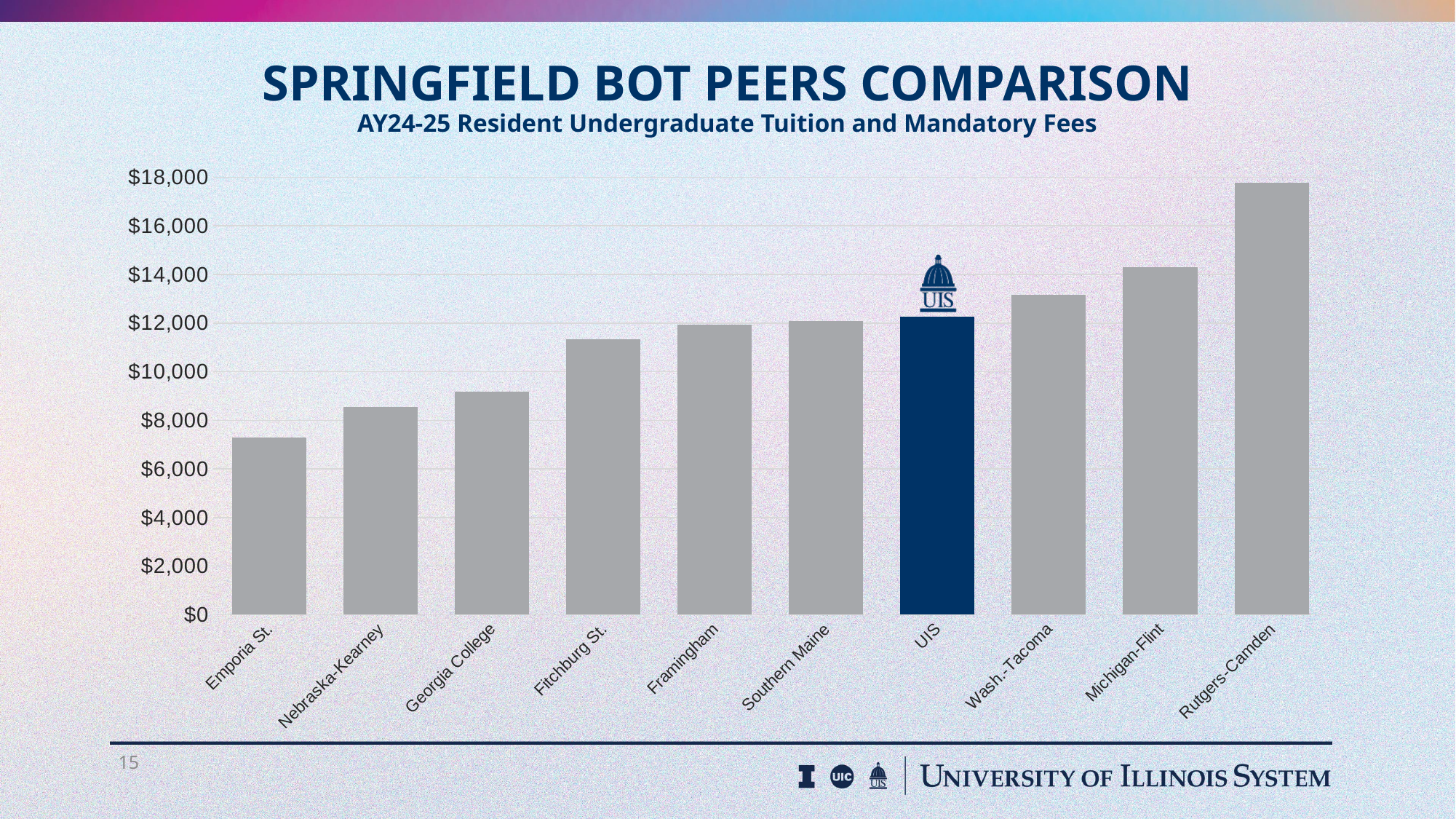
How many institutions are shown on the chart? 10 What kind of chart is shown on the slide? bar chart Do the values rise or fall moving from left to right along the x axis? rise Is the value for UIS greater or less than $14,000? less Which institution has the lowest resident undergraduate tuition and mandatory fees? Emporia St. Is the value for Emporia St. greater or less than $8,000? less Is the value for Fitchburg St. greater or less than $10,000? greater Which is larger, the value for Michigan-Flint or the value for UIS? Michigan-Flint Which institution has the highest resident undergraduate tuition and mandatory fees? Rutgers-Camden Which institution's bar is highlighted in dark blue? UIS